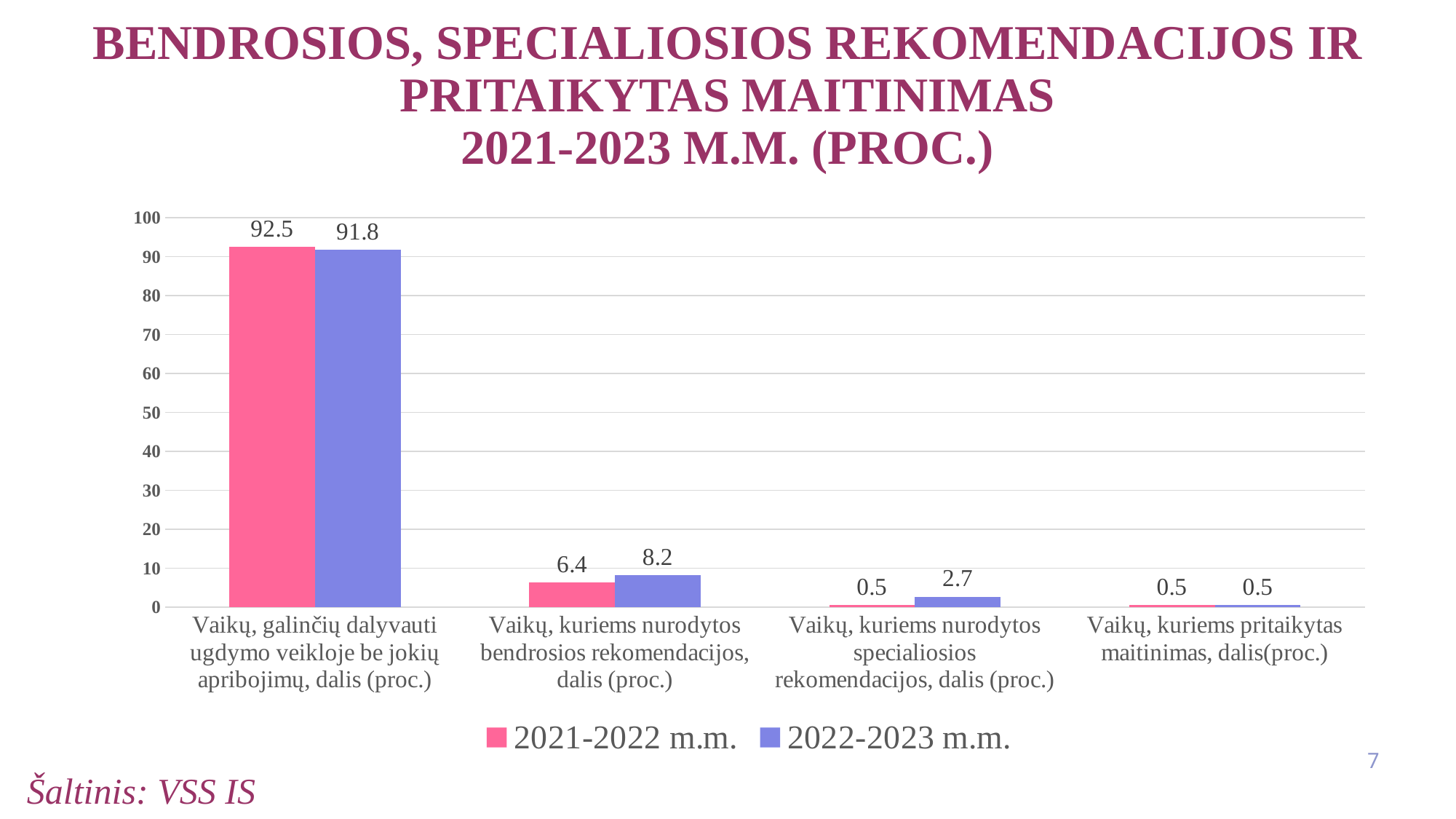
What is the difference between the 2021-2022 m.m. and 2022-2023 m.m. values for 'Vaikų, galinčių dalyvauti ugdymo veikloje be jokių apribojimų, dalis (proc.)'? 0.7 Which category has the highest value in the 2022-2023 m.m. series? Vaikų, galinčių dalyvauti ugdymo veikloje be jokių apribojimų, dalis (proc.) What is the difference between the 2021-2022 m.m. and 2022-2023 m.m. values for 'Vaikų, kuriems nurodytos specialiosios rekomendacijos, dalis (proc.)'? 2.2 Is the 2021-2022 m.m. value for 'Vaikų, galinčių dalyvauti ugdymo veikloje be jokių apribojimų, dalis (proc.)' greater or less than 90? greater For 'Vaikų, kuriems nurodytos bendrosios rekomendacijos, dalis (proc.)', which series has the larger value, 2021-2022 m.m. or 2022-2023 m.m.? 2022-2023 m.m. Which colour represents the 2022-2023 m.m. series in the chart? purple/blue What is the value for 'Vaikų, galinčių dalyvauti ugdymo veikloje be jokių apribojimų, dalis (proc.)' in the 2021-2022 m.m. series? 92.5 How many series does the legend list? 2 How many categories are shown on the x axis of the chart? 4 What is the value for 'Vaikų, kuriems nurodytos specialiosios rekomendacijos, dalis (proc.)' in the 2021-2022 m.m. series? 0.5 What kind of chart is shown on the slide? bar chart What is the value for 'Vaikų, kuriems nurodytos bendrosios rekomendacijos, dalis (proc.)' in the 2022-2023 m.m. series? 8.2